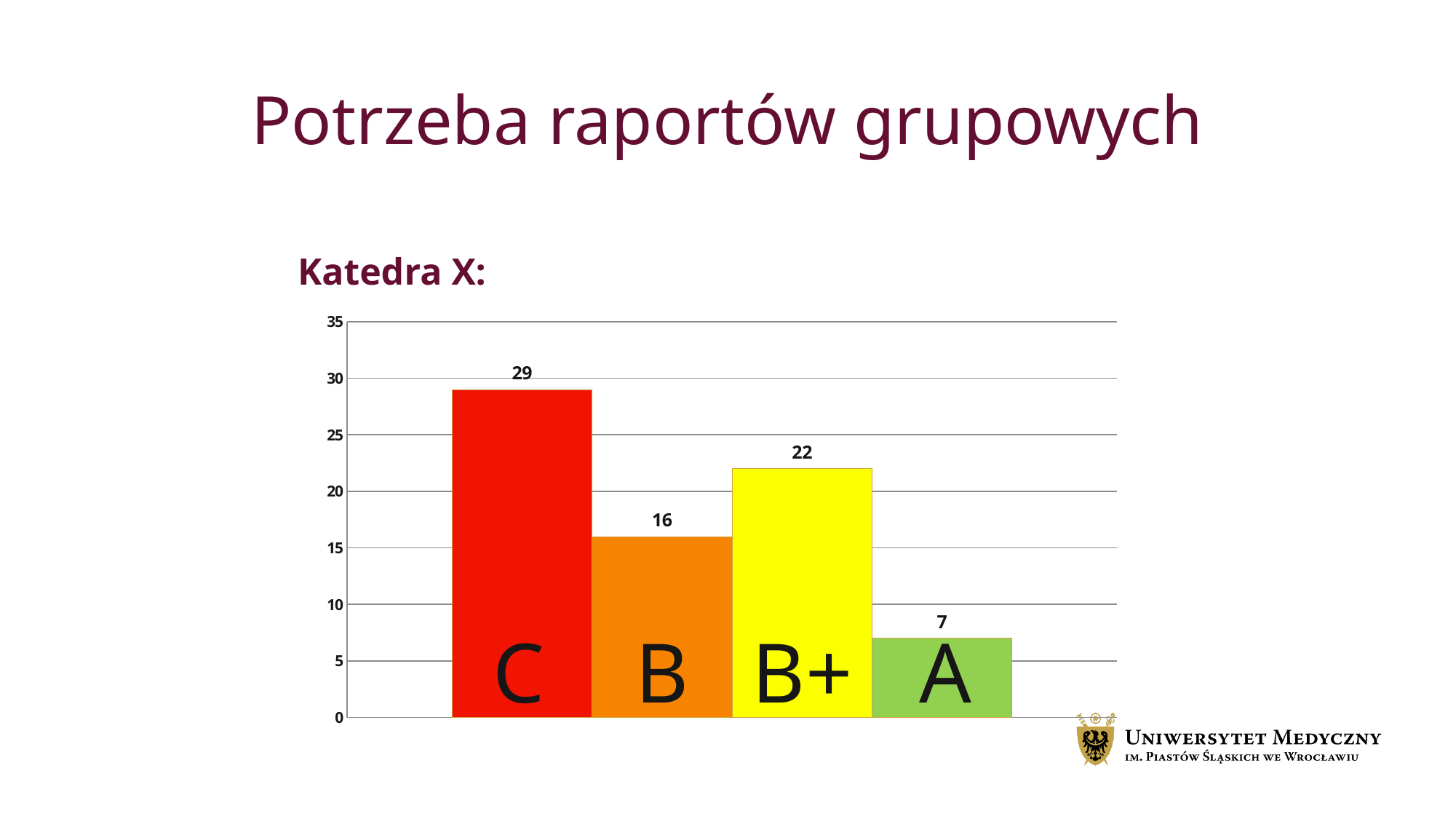
Which is larger, the value for B or the value for B+? B+ How many categories are shown in the chart? 4 What is the label above the chart? Katedra X: Is the value for B greater or less than 20? less What is the value for category C? 29 What is the value for category B+? 22 What is the difference between the values for B+ and A? 15 What is the value for category A? 7 What kind of chart is shown on the slide? bar chart Which category has the highest value? C What is the difference between the values for C and B? 13 Which category has the lowest value? A